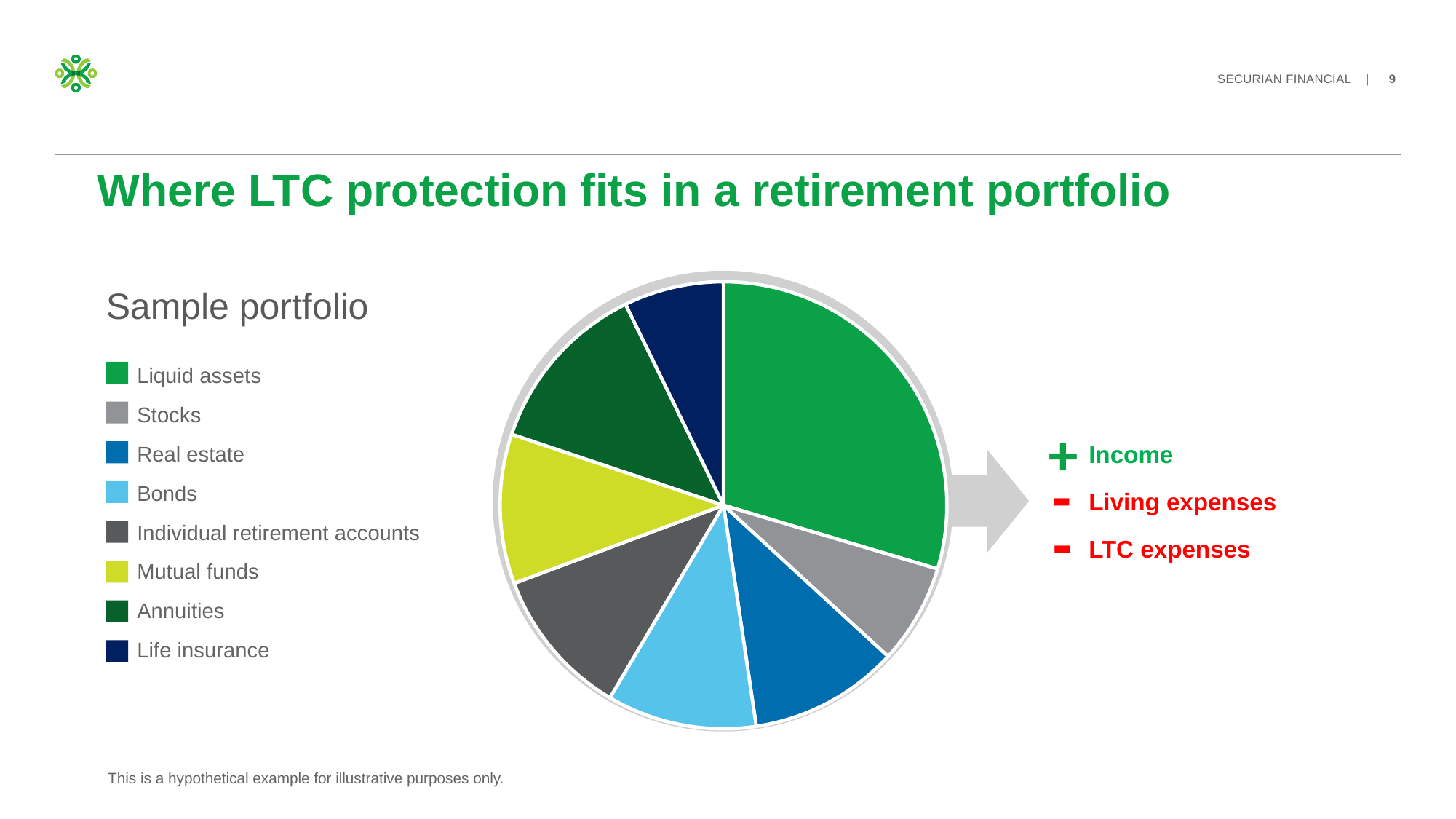
Which slice is larger in the pie chart, Liquid assets or Stocks? Liquid assets Which category has the largest slice in the pie chart? Liquid assets Which slice is larger in the pie chart, Liquid assets or Annuities? Liquid assets How many slices does the pie chart have? 8 How many categories does the legend of the pie chart list? 8 Which slice is larger in the pie chart, Mutual funds or Life insurance? Mutual funds What is the title shown above the legend of the pie chart? Sample portfolio Which category in the pie chart is shown in light blue? Bonds What kind of chart is shown on the slide? Pie chart